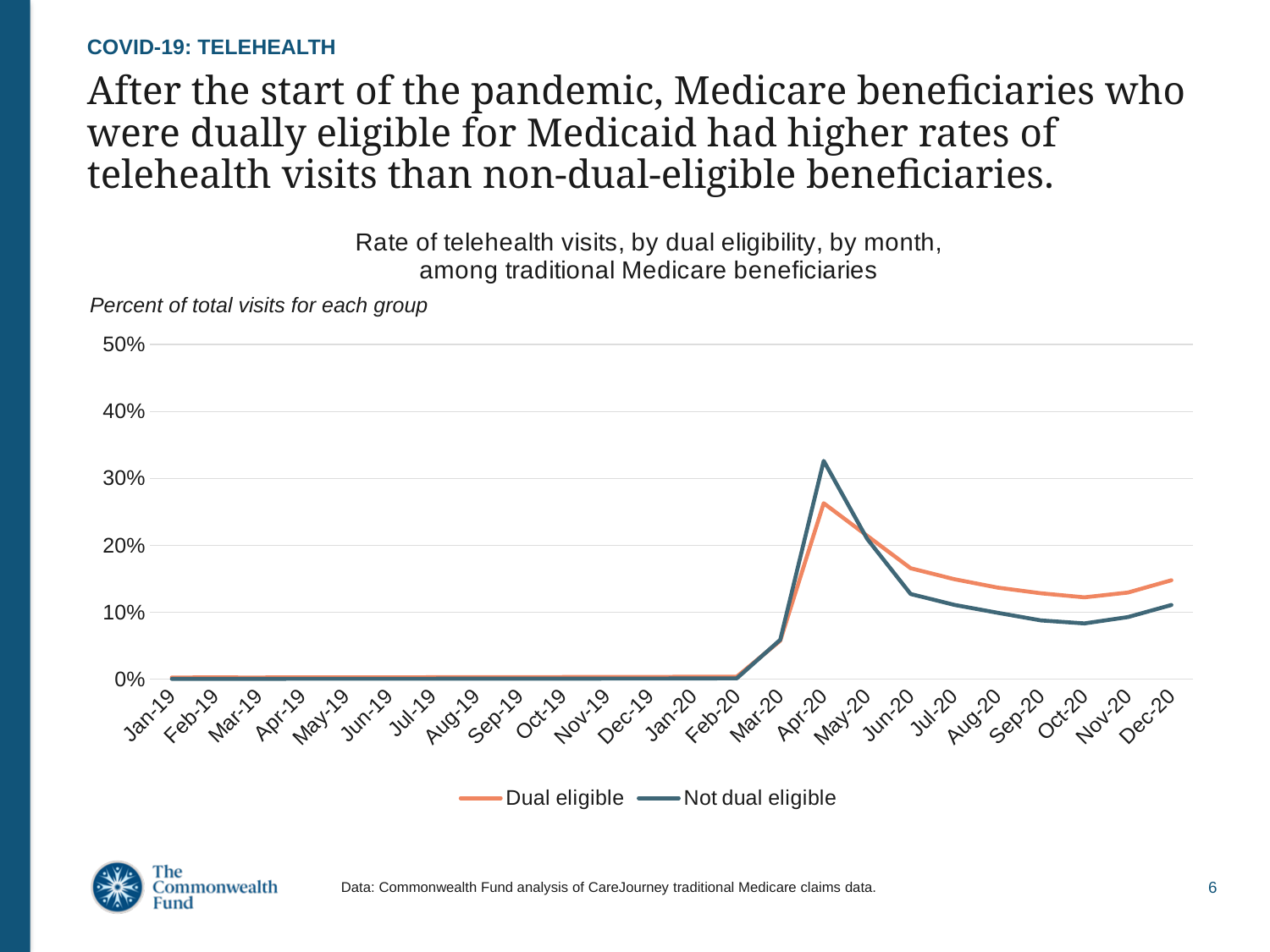
In which month does the Not dual eligible series reach its highest value? Apr-20 Is the value for Dual eligible in Apr-20 greater or less than 30%? less In which month does the Dual eligible series reach its highest value? Apr-20 What kind of chart is shown on the slide? Line chart In Dec-20, which series has the higher value, Dual eligible or Not dual eligible? Dual eligible In Apr-20, which series has the higher value, Dual eligible or Not dual eligible? Not dual eligible Is the value for Dual eligible in Dec-20 greater or less than 10%? greater Is the value for Not dual eligible in Apr-20 greater or less than 30%? greater How many months are shown along the x axis? 24 Does the Dual eligible series rise or fall from Apr-20 to Oct-20? Fall How many series does the legend list? 2